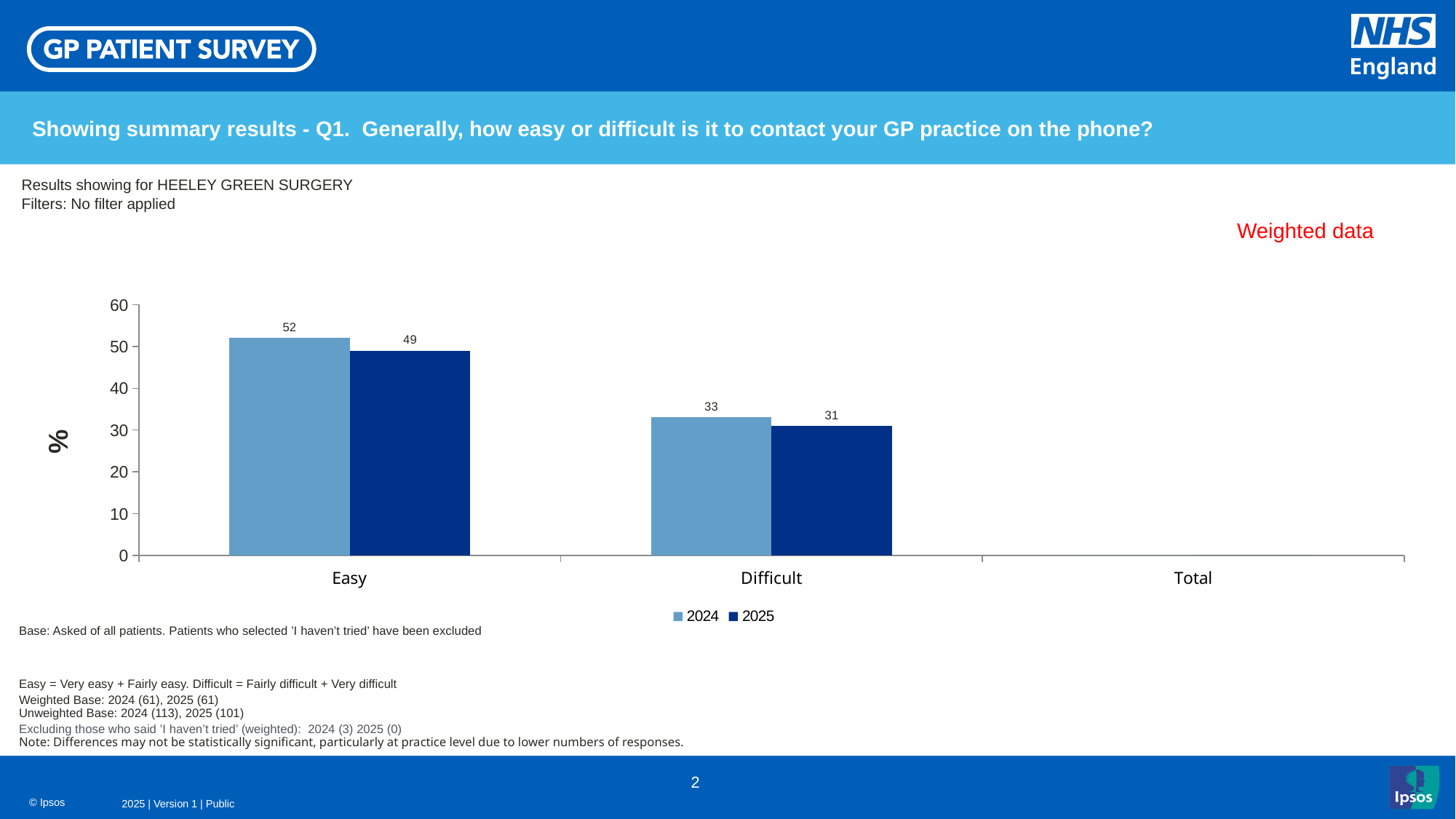
What is the value for Difficult in 2025? 31 What label is shown on the y axis of the chart? % How many series does the legend list? 2 Which category has the highest value for the 2024 series? Easy What is the difference between the Easy and Difficult values in 2025? 18 What is the value for Difficult in 2024? 33 What is the value for Easy in 2025? 49 What is the difference between the 2024 and 2025 values for Easy? 3 Which is larger, the 2024 value for Difficult or the 2025 value for Difficult? 2024 Which series is shown in the darker blue colour? 2025 What kind of chart is shown on the slide? Bar chart What is the value for Easy in 2024? 52